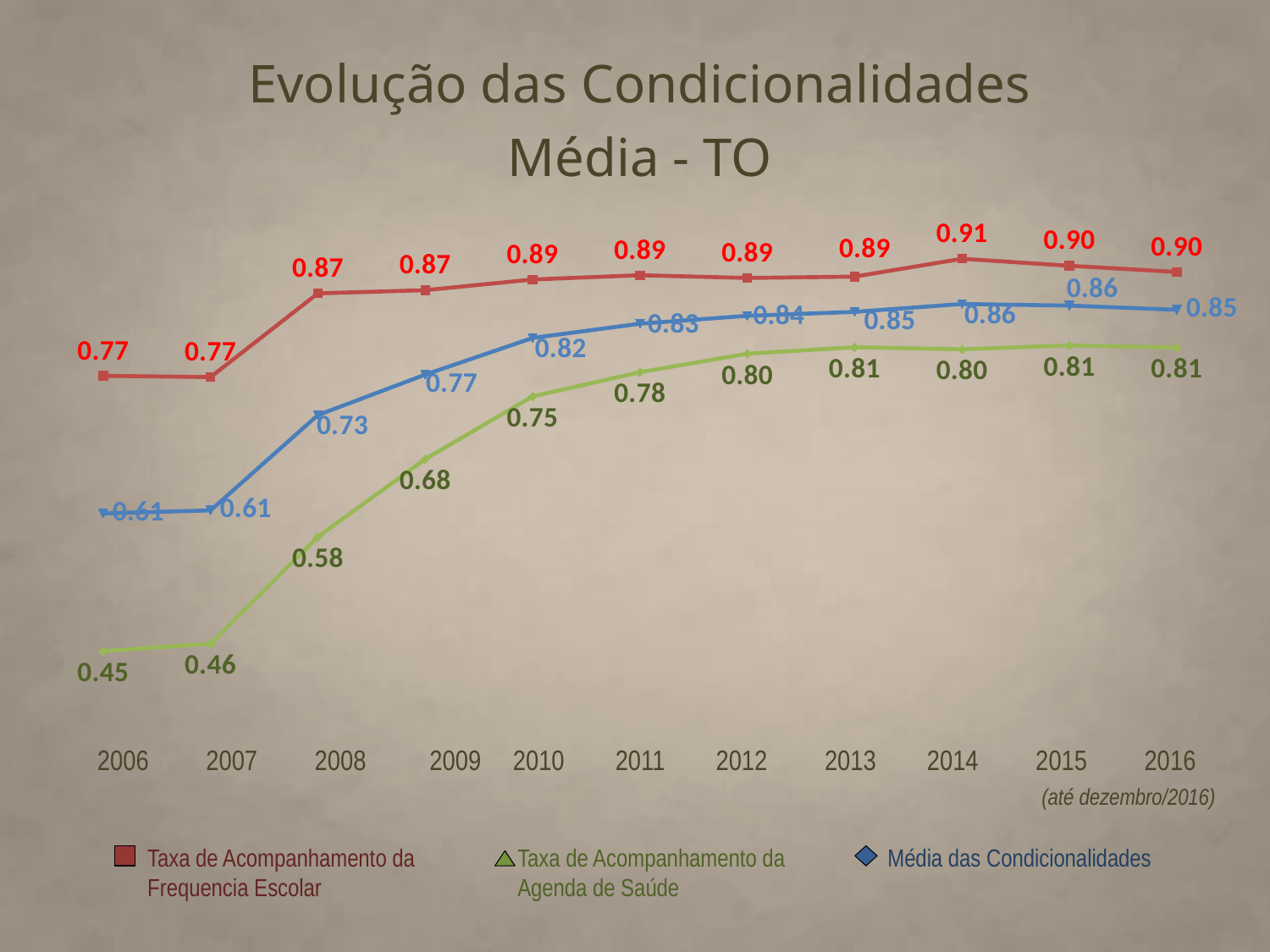
What is the value of Taxa de Acompanhamento da Frequencia Escolar in 2014? 0.91 Does Taxa de Acompanhamento da Agenda de Saúde generally rise or fall from 2006 to 2016? rise What is the difference between Taxa de Acompanhamento da Agenda de Saúde in 2016 and in 2006? 0.36 What is the title of the chart? Evolução das Condicionalidades Média - TO What kind of chart is shown on the slide? line chart What is the value of Média das Condicionalidades in 2010? 0.82 What is the value of Taxa de Acompanhamento da Agenda de Saúde in 2006? 0.45 How many series does the legend list? 3 In which year is Taxa de Acompanhamento da Agenda de Saúde lowest? 2006 In which year is Taxa de Acompanhamento da Frequencia Escolar highest? 2014 How many years are shown on the x axis? 11 Which series has the higher value in 2008: Taxa de Acompanhamento da Frequencia Escolar or Taxa de Acompanhamento da Agenda de Saúde? Taxa de Acompanhamento da Frequencia Escolar